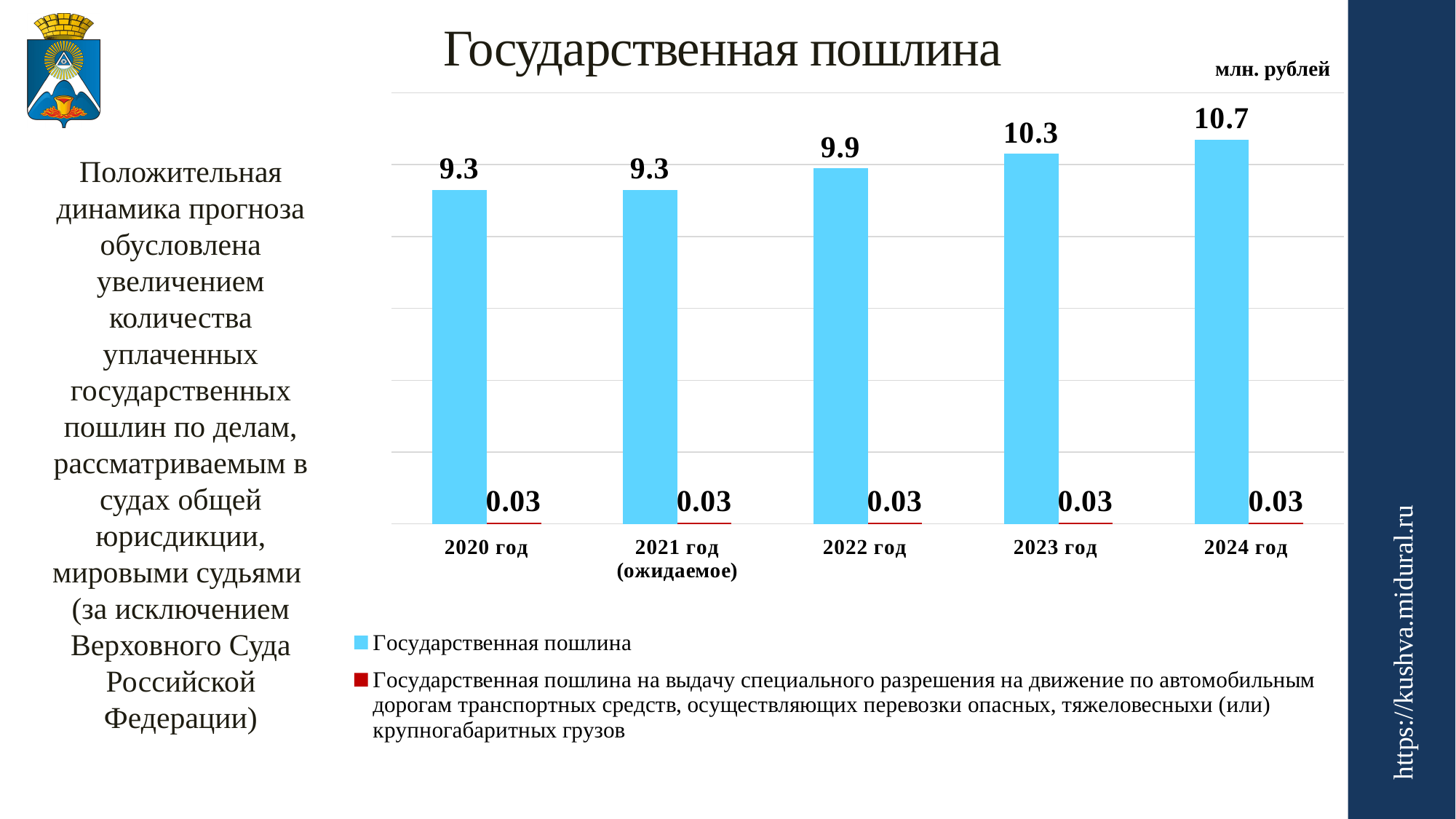
Which is larger: the Государственная пошлина value for 2022 год or for 2021 год (ожидаемое)? 2022 год How many series does the legend list? 2 What is the difference between the Государственная пошлина values for 2023 год and 2022 год? 0.4 Does the Государственная пошлина series rise or fall from 2020 год to 2024 год? Rises What is the value of Государственная пошлина for 2022 год? 9.9 What is the difference between the Государственная пошлина values for 2024 год and 2020 год? 1.4 What is the value of Государственная пошлина for 2024 год? 10.7 Which year has the highest value of Государственная пошлина? 2024 год What type of chart is shown on the slide? Bar chart What unit is indicated in the top right corner of the chart? млн. рублей What is the value of the red series (Государственная пошлина на выдачу специального разрешения...) for 2023 год? 0.03 How many years (categories) are shown on the x axis? 5